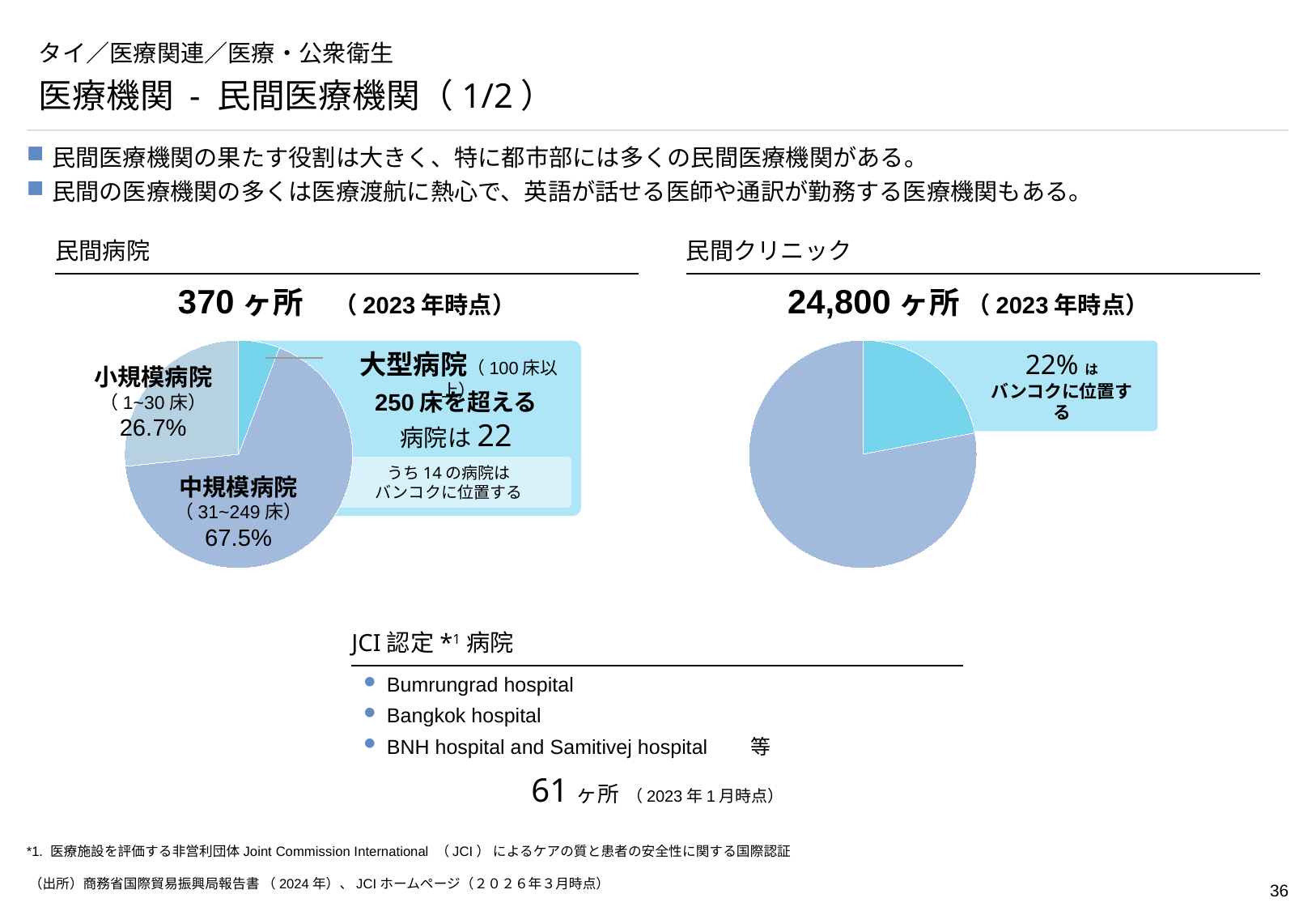
In the 民間病院 pie chart on the left, which category has the smallest slice? 大型病院 In the 民間病院 pie chart on the left, what is the difference in percentage points between 中規模病院 and 小規模病院? 40.8 percentage points What total number of 民間クリニック is stated above the right pie chart? 24,800 ヶ所 How many slices does the 民間クリニック pie chart on the right have? 2 In the 民間病院 pie chart on the left, what share is shown for 中規模病院? 67.5% What kind of chart is used for 民間病院 on the left of the slide? Pie chart In the 民間病院 pie chart on the left, which is larger, the share for 小規模病院 or the share for 中規模病院? 中規模病院 What total number of 民間病院 is stated above the left pie chart? 370 ヶ所 How many slices does the 民間病院 pie chart on the left have? 3 In the 民間病院 pie chart on the left, what share is shown for 小規模病院? 26.7% In the 民間病院 pie chart on the left, which category has the largest slice? 中規模病院 In the 民間クリニック pie chart on the right, what share of clinics is located in Bangkok? 22%